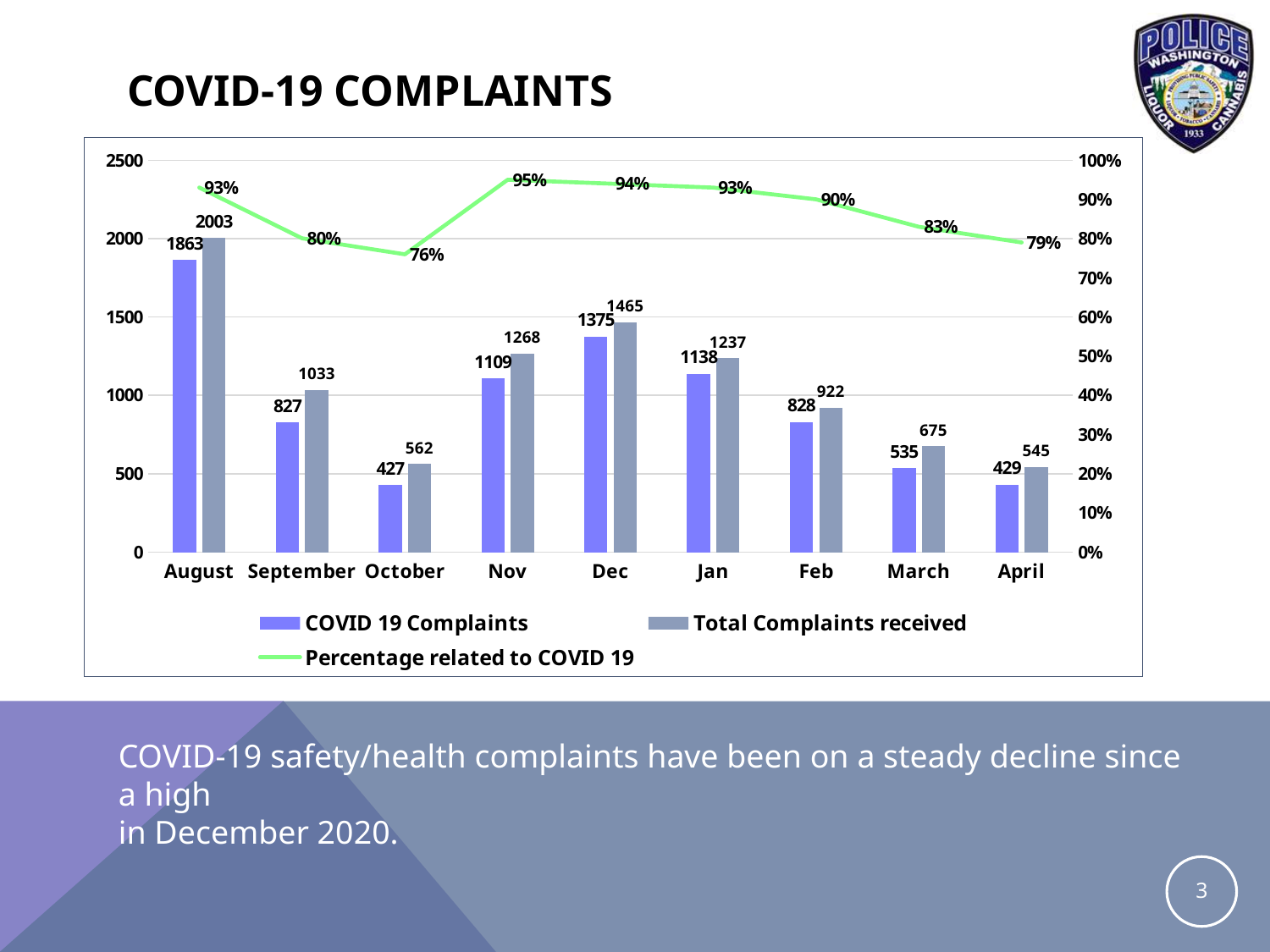
Which month has the lowest Total Complaints received? April What was the Total Complaints received in Dec? 1465 What kind of chart is this? Combined bar and line chart Which is larger: COVID 19 Complaints in Feb or COVID 19 Complaints in March? Feb What is the difference between Total Complaints received and COVID 19 Complaints in Jan? 99 How many series does the legend list? 3 Which month has the highest number of COVID 19 Complaints? August What was the Percentage related to COVID 19 in October? 76% How many months are shown on the x axis? 9 How many COVID 19 Complaints were received in August? 1863 Which month has the highest Percentage related to COVID 19? Nov Does the Percentage related to COVID 19 rise or fall from Nov to April? Fall